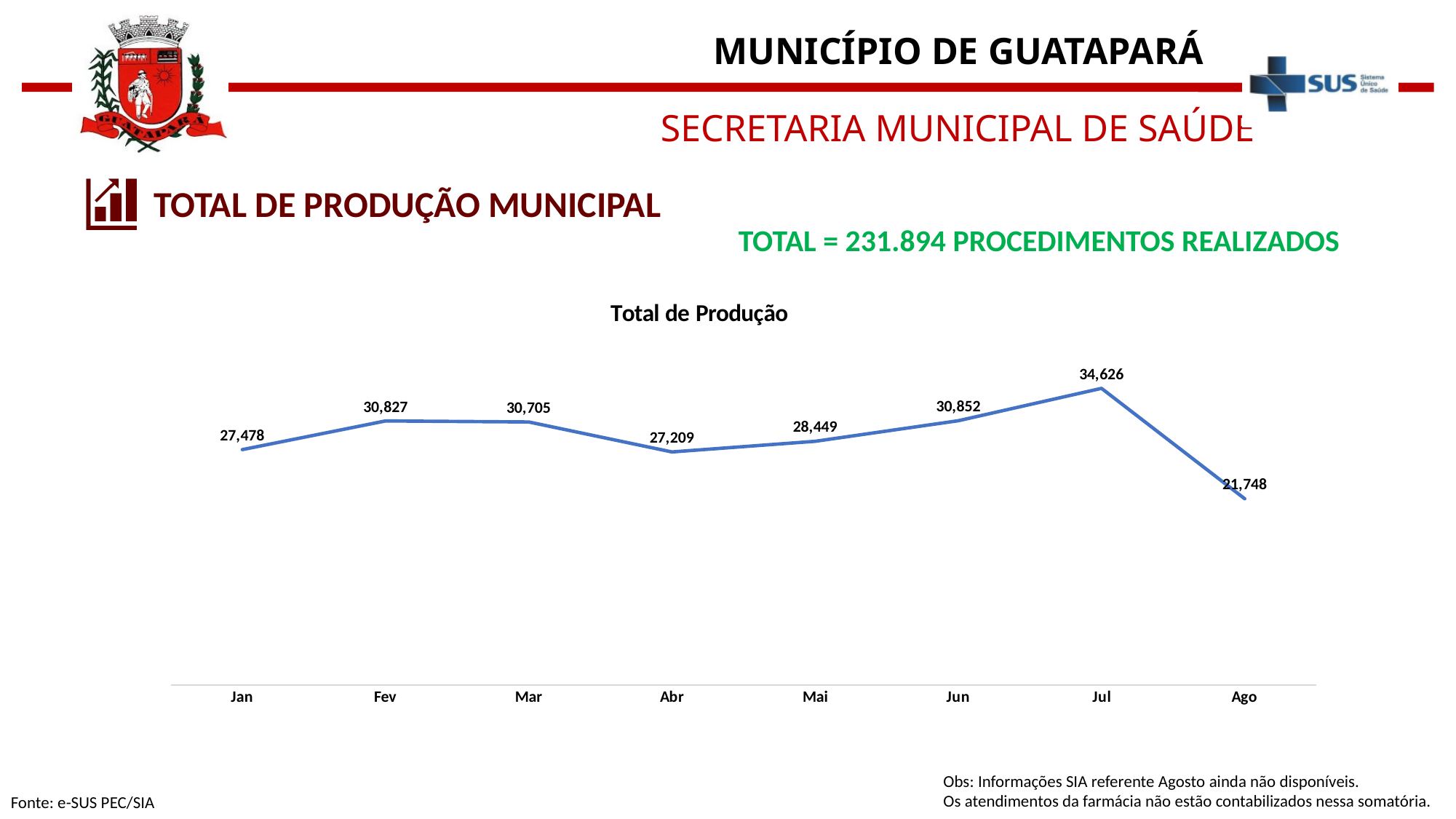
What is the title of the chart? Total de Produção What is the value for Jan in the chart? 27,478 What is the value for Jul in the chart? 34,626 How many months are plotted on the x axis of the chart? 8 Which month has the highest value in the chart? Jul What type of chart is shown on the slide? Line chart Which month has the lowest value in the chart? Ago What is the difference between the values for Jun and Mai? 2,403 Which is larger, the value for Jun or the value for Mai? Jun What is the difference between the values for Jul and Ago? 12,878 What is the value for Abr in the chart? 27,209 Does the value rise or fall from Jul to Ago? Fall